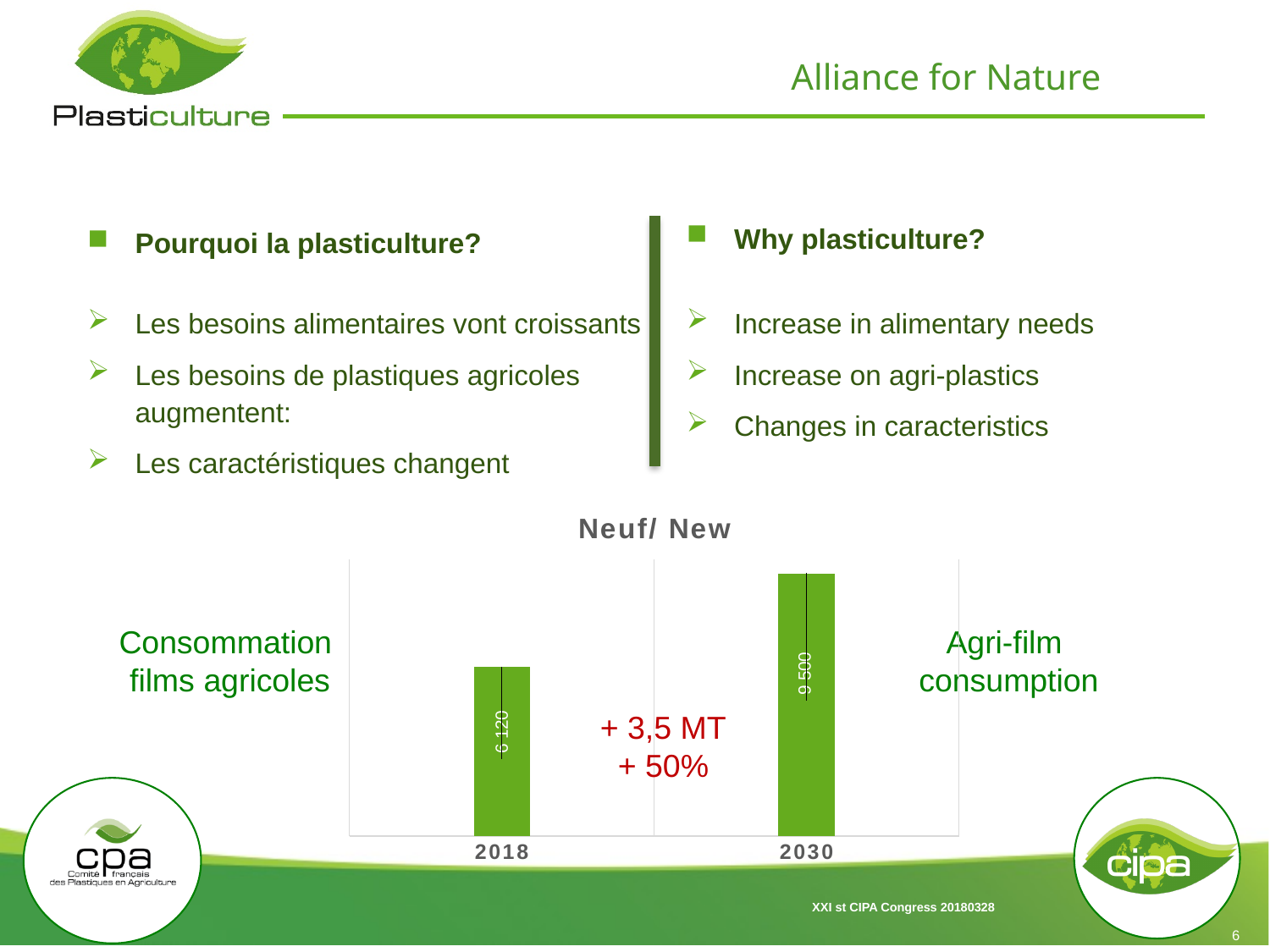
Which year has the lower value? 2018 Which year has the higher value? 2030 What is the value shown for 2030? 9 500 What type of chart is shown on the slide? bar chart What is the title of the chart? Neuf/ New What is the value shown for 2018? 6 120 Do the values rise or fall from 2018 to 2030? rise What percentage increase is annotated between the two bars? + 50% What is the difference between the 2030 value and the 2018 value? 3 380 Is the value for 2030 larger or smaller than the value for 2018? larger How many bars are plotted in the chart? 2